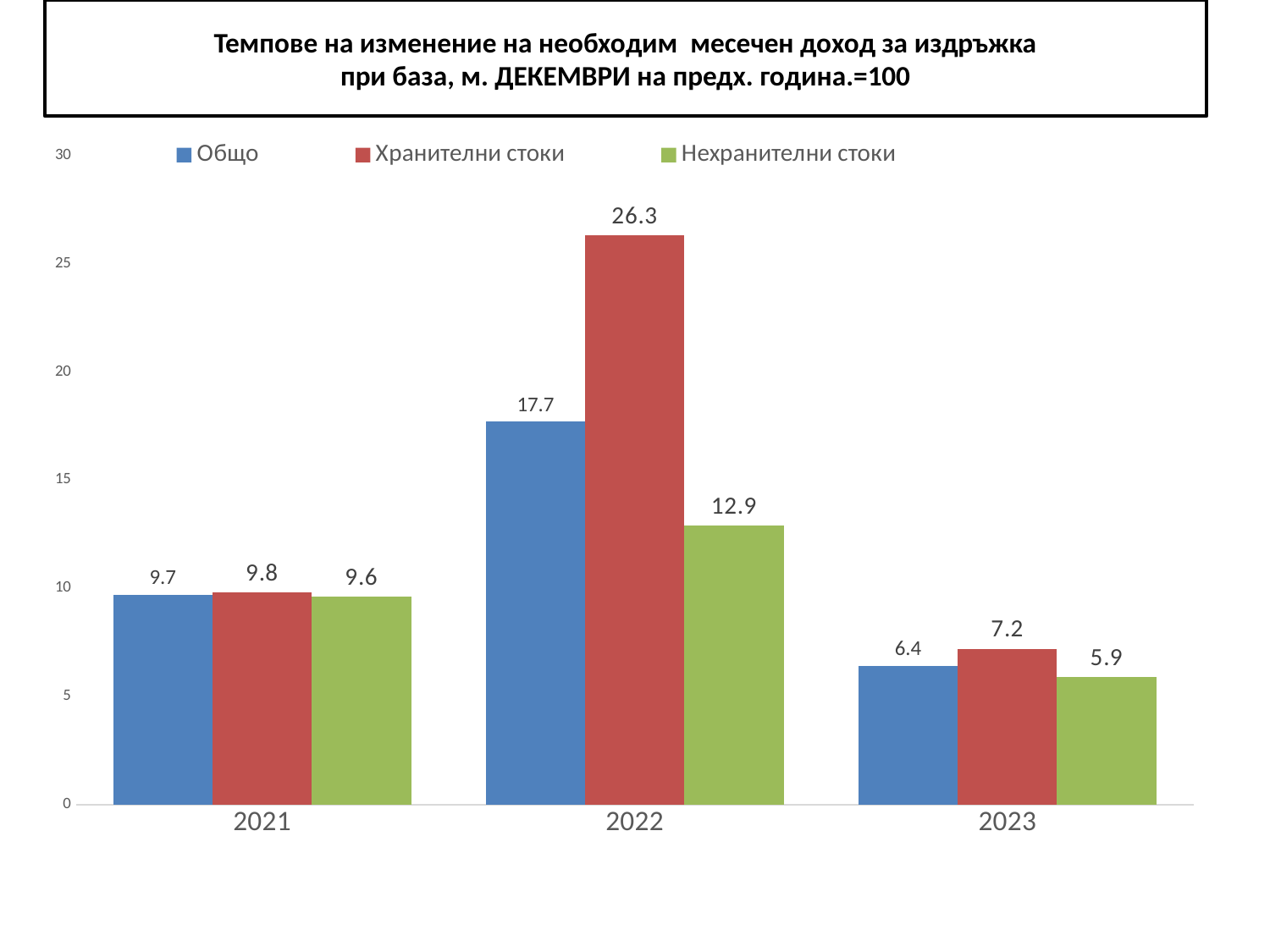
What is the difference between Хранителни стоки and Нехранителни стоки in 2022? 13.4 Does the value for Общо rise or fall from 2022 to 2023? Fall How many years are shown on the x axis? 3 What is the value for Нехранителни стоки in 2023? 5.9 In which year is the value for Общо highest? 2022 In which year is the value for Хранителни стоки lowest? 2023 What kind of chart is shown on the slide? Bar chart Which is larger in 2023: Хранителни стоки or Нехранителни стоки? Хранителни стоки What is the value for Общо in 2021? 9.7 What is the value for Хранителни стоки in 2022? 26.3 How many series does the legend list? 3 Which colour represents Нехранителни стоки in the legend? Green